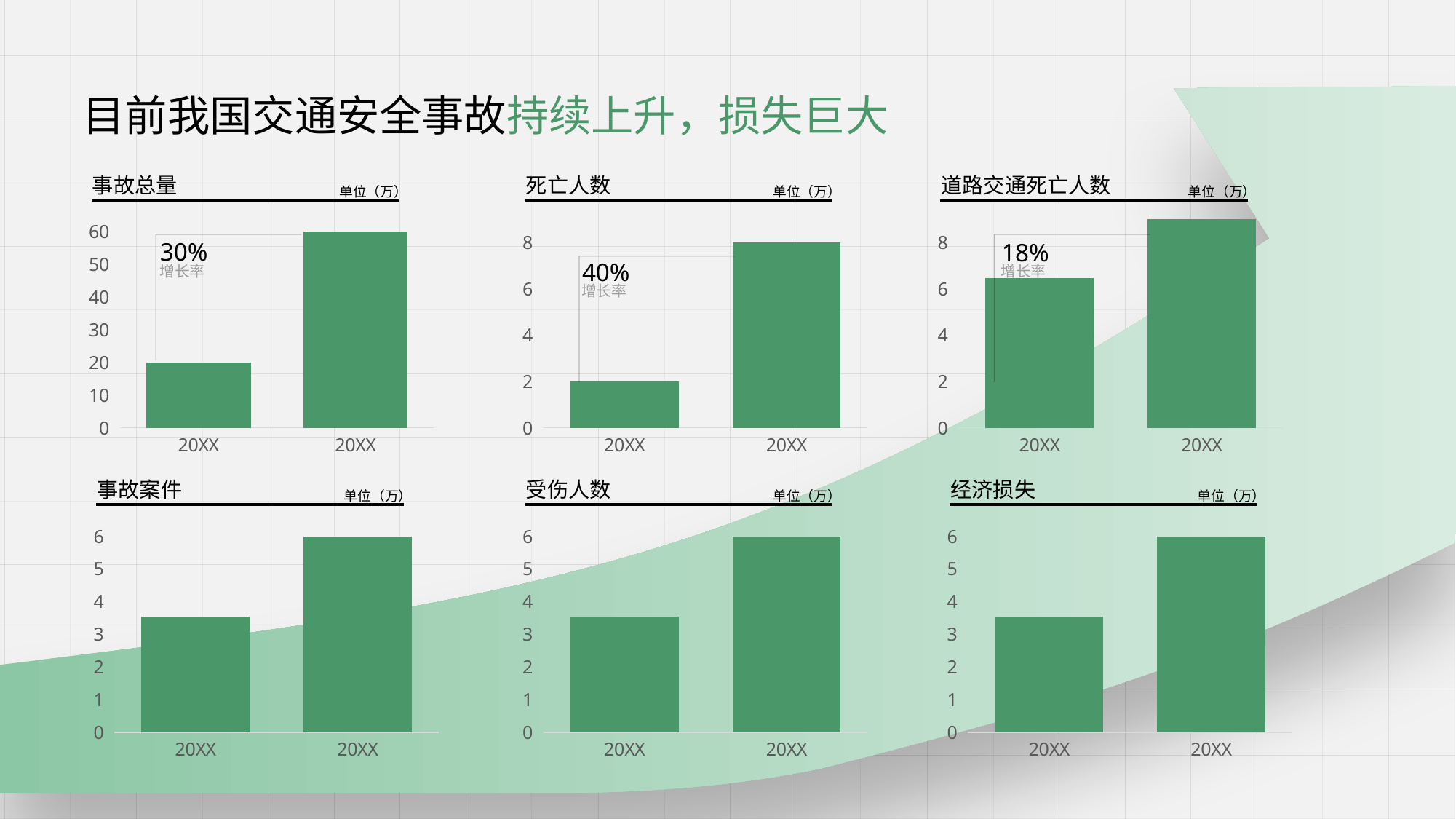
What growth rate (增长率) is printed on the 事故总量 chart? 30% In the 事故总量 chart, is the value for the right 20XX bar greater or less than 50? greater In the 事故总量 chart, is the value for the left 20XX bar greater or less than 30? less In the 事故案件 chart, do the values rise or fall from the left bar to the right bar? rise In the 死亡人数 chart, is the value for the left 20XX bar greater or less than 4? less How many bars does the 经济损失 chart have? 2 How many charts are on the slide? 6 What kind of chart is the 事故总量 chart? bar chart What growth rate (增长率) is printed on the 死亡人数 chart? 40% In the 道路交通死亡人数 chart, which bar is higher, the left 20XX bar or the right 20XX bar? the right 20XX bar